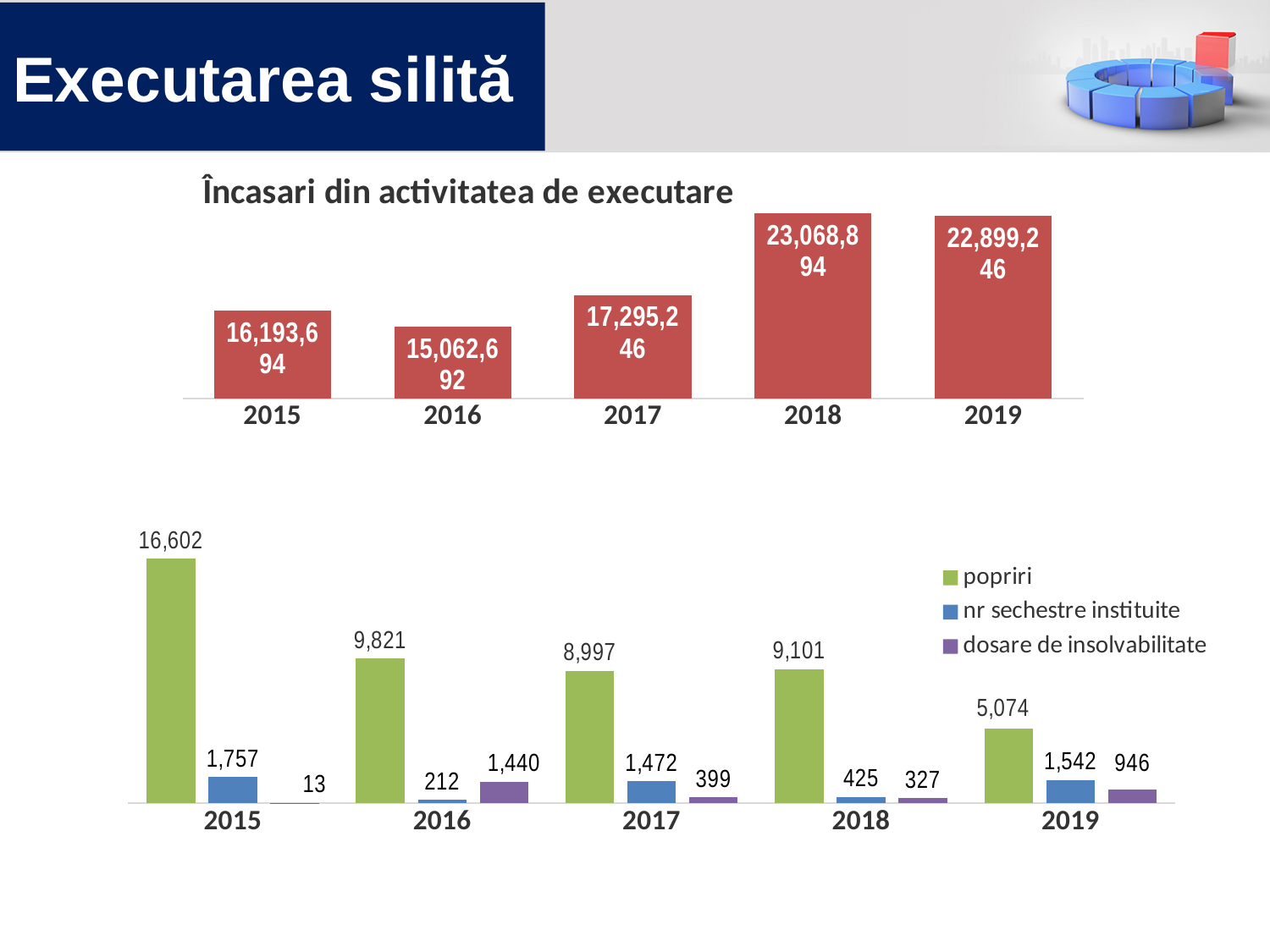
In the bottom chart, how many series does the legend list? 3 In the bottom chart, what is the value of 'popriri' for 2015? 16,602 In the chart 'Încasari din activitatea de executare', which year has the lowest value? 2016 In the chart 'Încasari din activitatea de executare', which year has the highest value? 2018 In the chart 'Încasari din activitatea de executare', what is the difference between the 2017 and 2016 values? 2,232,554 What kind of chart is the bottom chart? bar chart In the chart 'Încasari din activitatea de executare', what is the value for 2018? 23,068,894 In the bottom chart, what is the value of 'dosare de insolvabilitate' for 2016? 1,440 In the bottom chart, what is the difference between 'nr sechestre instituite' in 2015 and in 2016? 1,545 In the bottom chart, which is larger for 2019: 'nr sechestre instituite' or 'dosare de insolvabilitate'? nr sechestre instituite In the chart 'Încasari din activitatea de executare', how many years are shown? 5 In the bottom chart, which year has the lowest value for 'popriri'? 2019